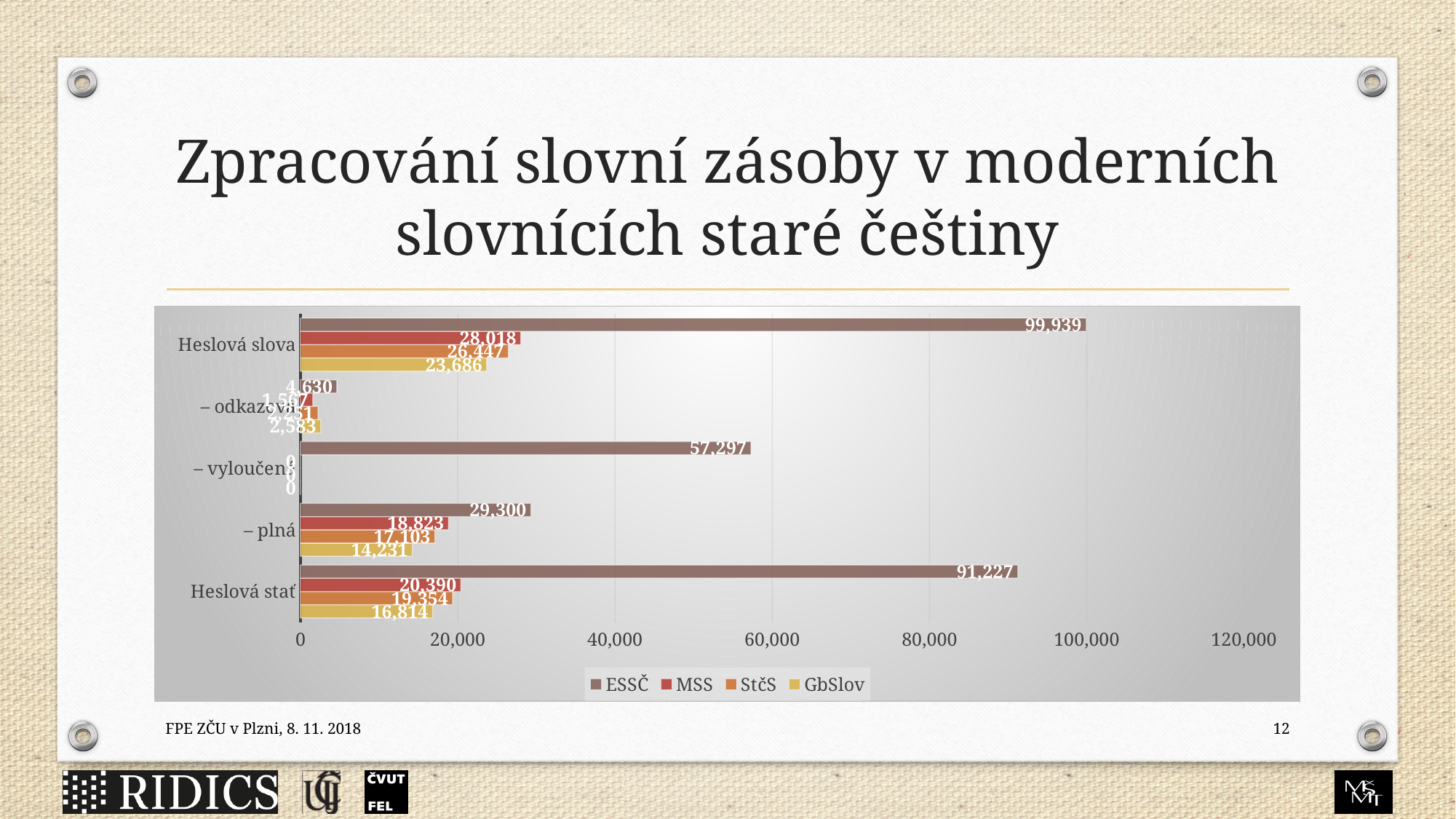
Which series has the lowest value for – plná? GbSlov What is the MSS value for – plná? 18,823 What type of chart is shown on the slide? bar chart What is the difference between the ESSČ values for Heslová slova and Heslová stať? 8,712 What is the GbSlov value for Heslová stať? 16,814 Which series has the highest value for Heslová stať? ESSČ How many categories are shown on the vertical axis of the chart? 5 What is the ESSČ value for – vyloučená? 57,297 Which series is shown in yellow in the legend? GbSlov What is the ESSČ value for Heslová slova? 99,939 How many series does the legend list? 4 Which is larger: the StčS value for Heslová slova or the StčS value for Heslová stať? Heslová slova